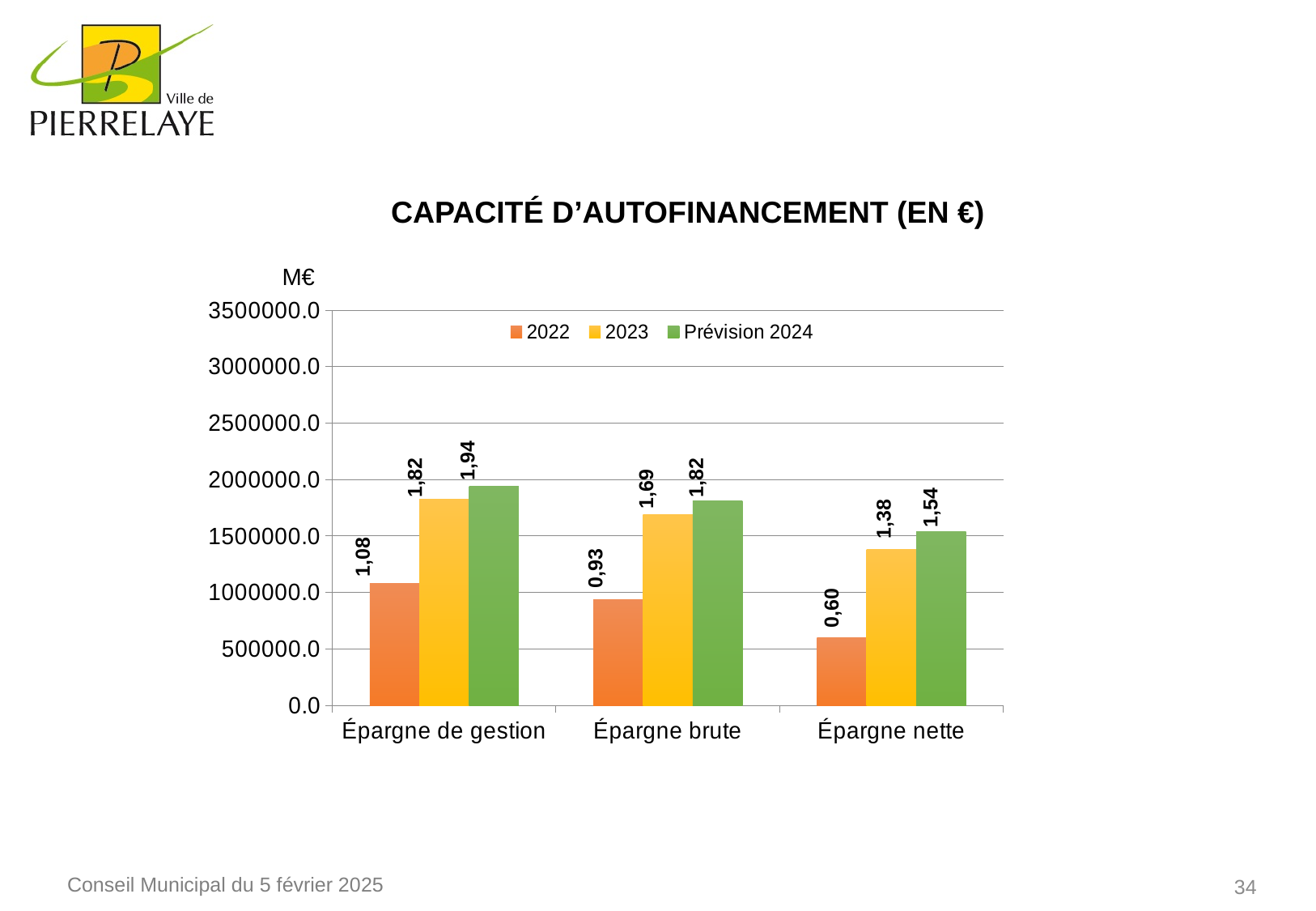
What is the value for Prévision 2024 for Épargne nette? 1,54 What kind of chart is shown on the slide? bar chart What is the difference between the Prévision 2024 and 2022 values for Épargne de gestion? 0,86 What is the difference between the Prévision 2024 and 2023 values for Épargne brute? 0,13 Which category has the lowest value for 2022? Épargne nette Which is larger: the 2023 value for Épargne nette or the 2022 value for Épargne de gestion? 2023 value for Épargne nette How many series does the legend list? 3 How many categories are shown on the x axis? 3 Which category has the highest value for Prévision 2024? Épargne de gestion What is the value for 2022 for Épargne de gestion? 1,08 Is the 2022 bar for Épargne brute greater or less than 1000000.0 on the axis? less What is the value for 2023 for Épargne brute? 1,69